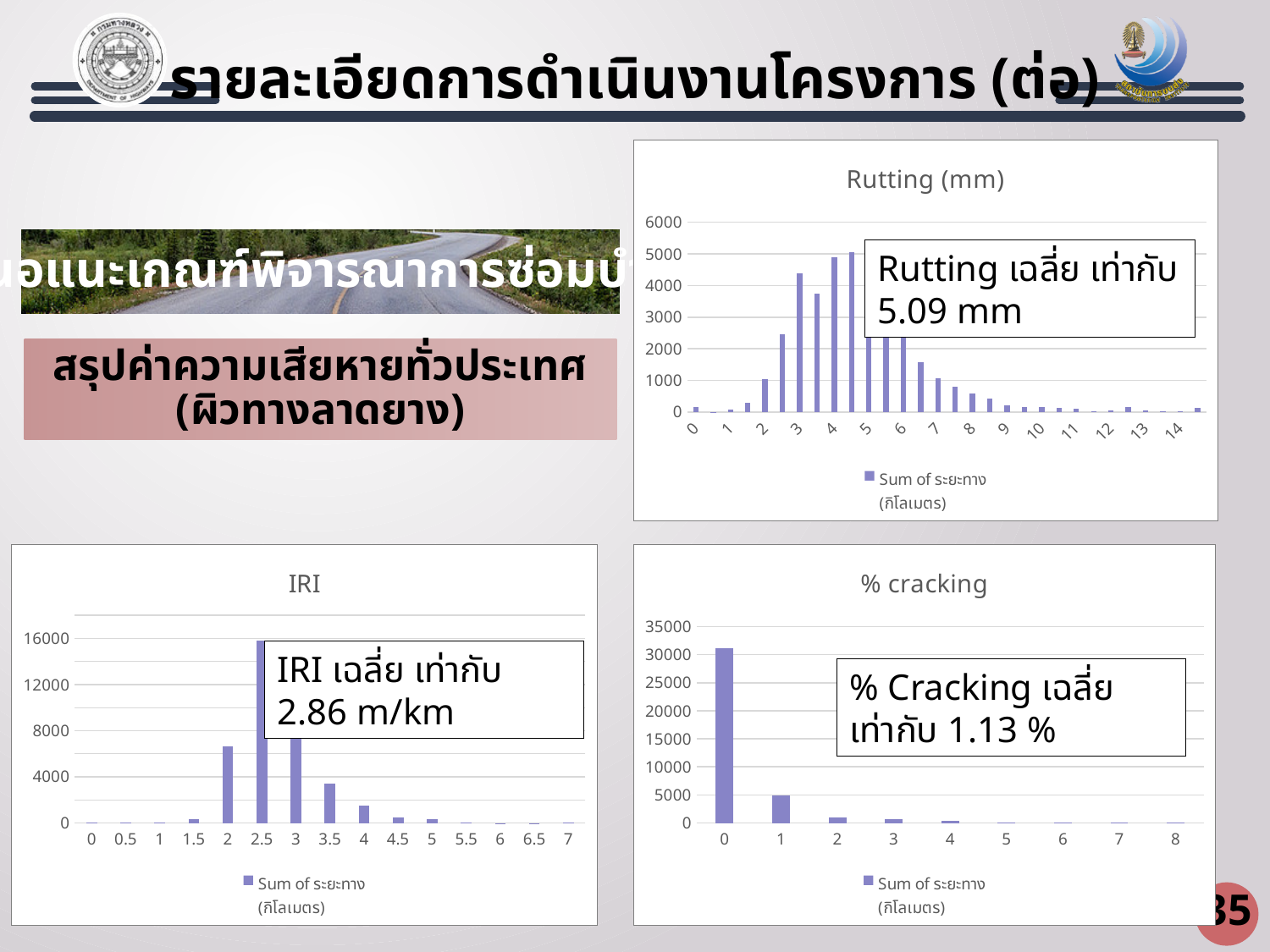
In the "IRI" chart, is the value for 3.5 greater or less than 4000? less How many series does the legend of the "Rutting (mm)" chart list? 1 In the "Rutting (mm)" chart, which is larger, the value for 3 or the value for 8? 3 In the "% cracking" chart, is the value for 1 greater or less than 10000? less What kind of chart is the "Rutting (mm)" chart? bar chart In the "Rutting (mm)" chart, is the value for 2 greater or less than 2000? less In the "IRI" chart, which category has the highest value? 2.5 In the "% cracking" chart, which category has the highest value? 0 How many categories are shown on the x axis of the "IRI" chart? 15 According to the text box on the "IRI" chart, what is the average IRI? 2.86 m/km